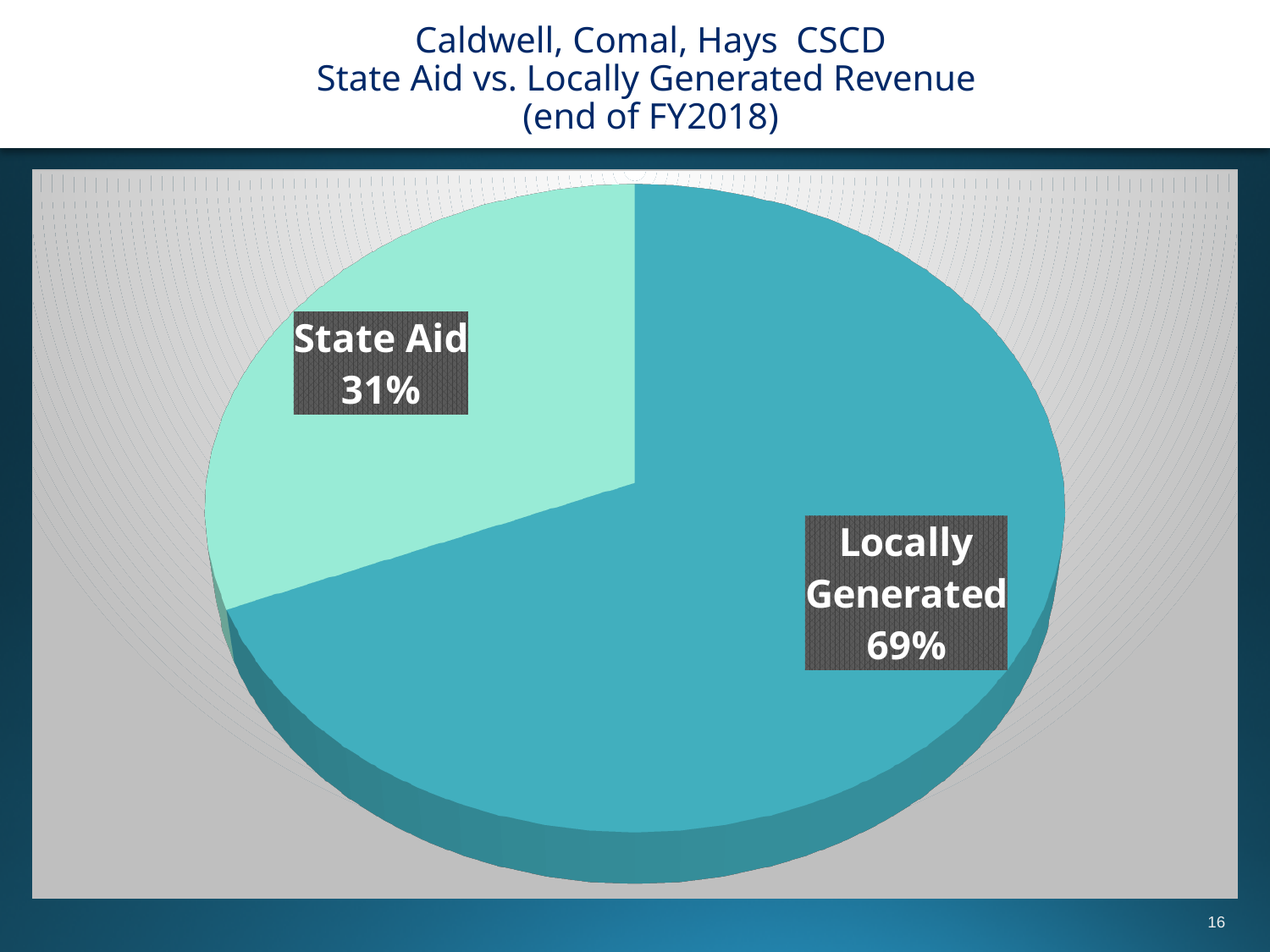
How many slices does the pie chart have? 2 What kind of chart is shown on the slide? pie chart Is the share for State Aid greater or less than 50%? less Which CSCD does the chart cover, according to the title? Caldwell, Comal, Hays CSCD What share of revenue is Locally Generated? 69% What share of revenue is State Aid? 31% Which slice of the pie is the smallest? State Aid What fiscal year does the chart title refer to? FY2018 What is the difference in percentage points between Locally Generated and State Aid? 38 Which slice of the pie is the largest? Locally Generated Which is larger, State Aid or Locally Generated? Locally Generated